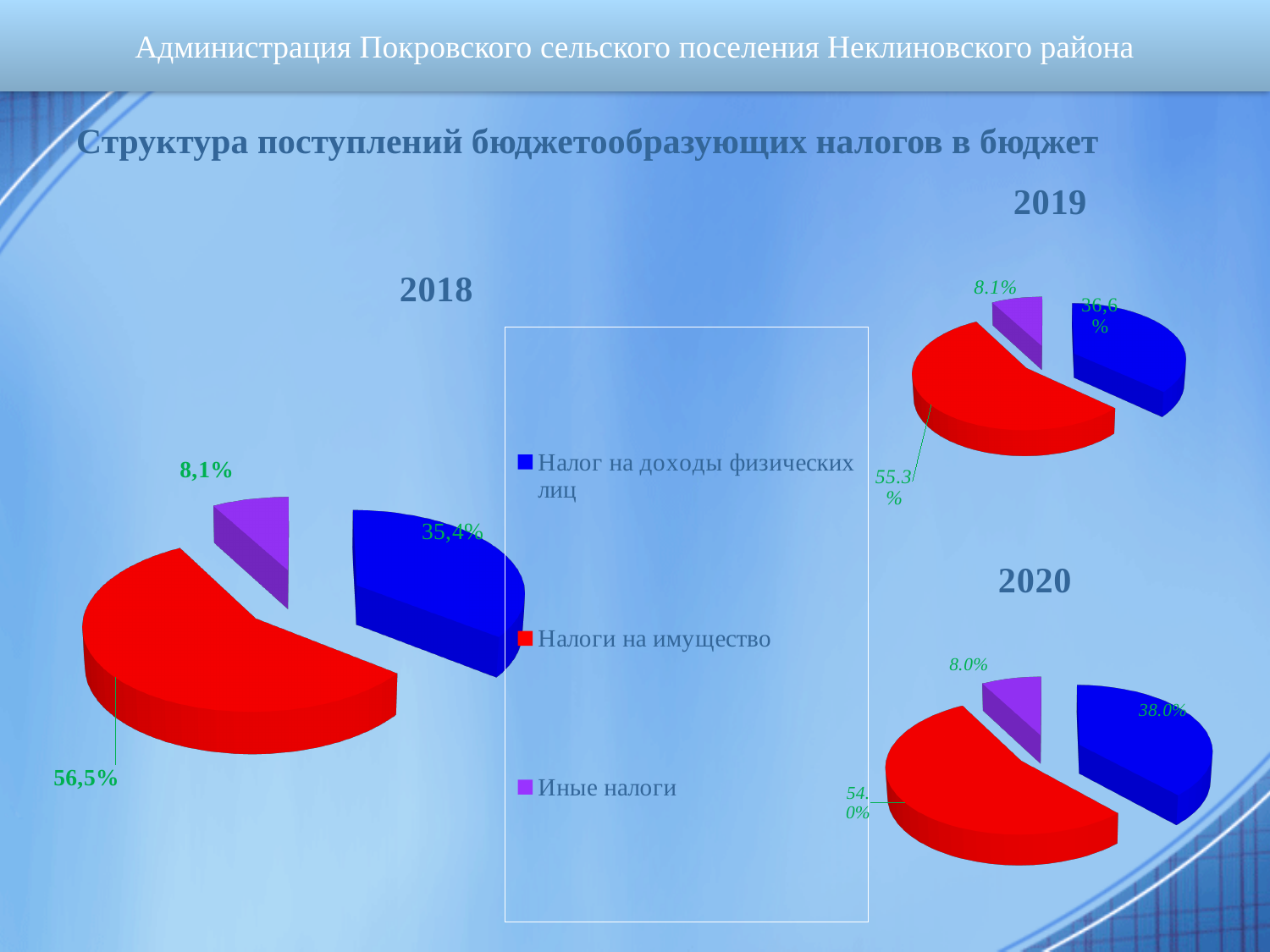
In the 2020 chart, which is larger: the share of Налог на доходы физических лиц or the share of Иные налоги? Налог на доходы физических лиц In the 2018 chart, what share is shown for Налоги на имущество? 56,5% In the 2020 chart, what share is shown for Иные налоги? 8.0% In the 2018 chart, what is the difference between the shares of Налоги на имущество and Налог на доходы физических лиц? 21,1% In the 2019 chart, which category has the smallest share? Иные налоги In the 2018 chart, what share is shown for Налог на доходы физических лиц? 35,4% What kind of chart is used for the 2018 data? Pie chart In the 2018 chart, what share is shown for Иные налоги? 8,1% In the 2020 chart, what share is shown for Налог на доходы физических лиц? 38.0% In the 2020 chart, which category has the largest share? Налоги на имущество How many categories does the legend list? 3 In the 2019 chart, what share is shown for Налоги на имущество? 55.3%